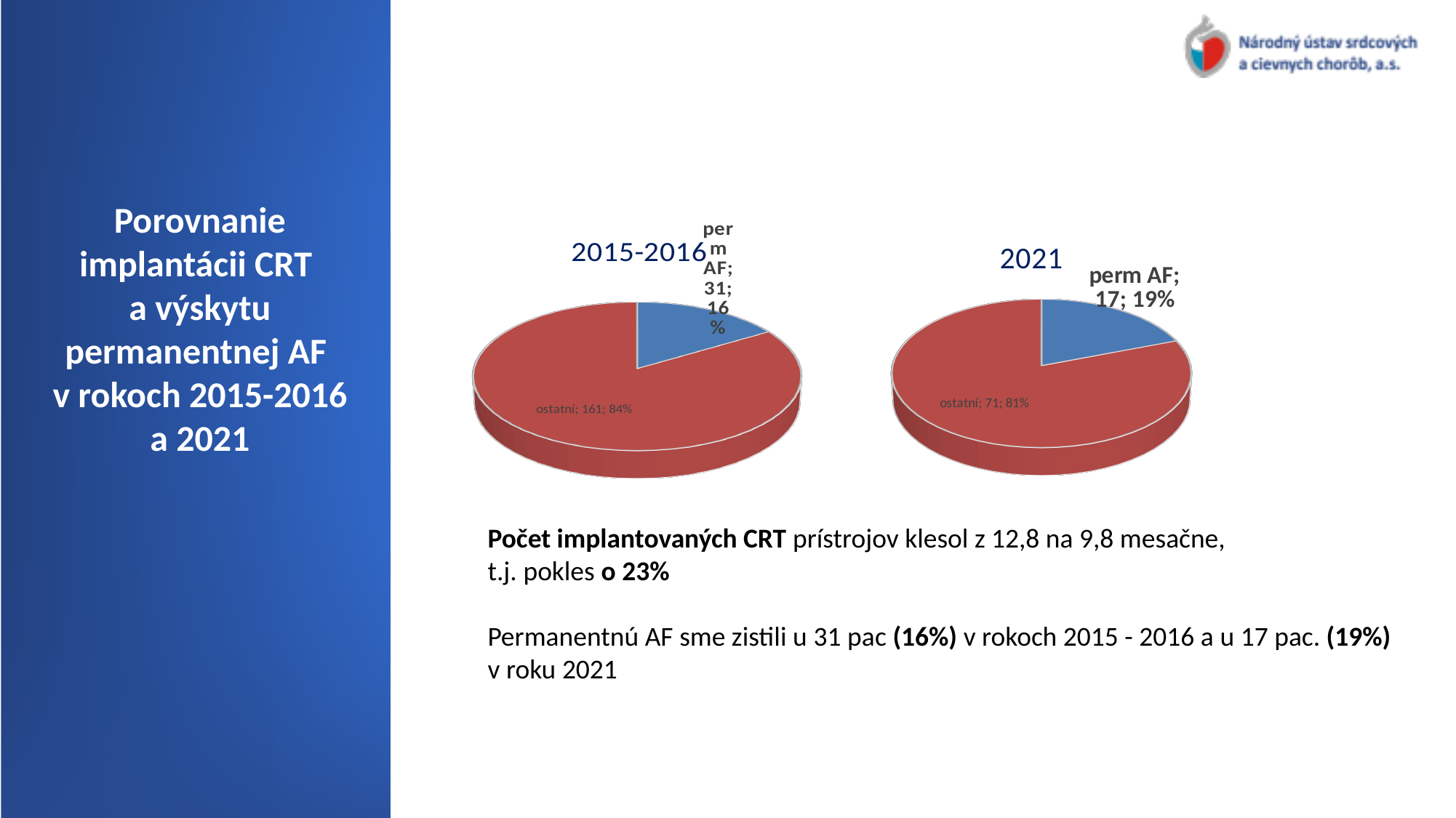
In the 2015-2016 chart, which slice is the smallest? perm AF Which is larger: the perm AF value in the 2015-2016 chart or the perm AF value in the 2021 chart? 2015-2016 In the 2021 chart, which slice is the largest? ostatní In the 2021 chart, what is the value for perm AF? 17 What type of chart is used for the 2015-2016 data? pie chart In the 2021 chart, what share of the pie does ostatní represent? 81% In the 2015-2016 chart, what share of the pie does perm AF represent? 16% In the 2021 chart, what is the value for ostatní? 71 In the 2015-2016 chart, what is the difference between the ostatní value and the perm AF value? 130 In the 2015-2016 chart, what is the value for perm AF? 31 How many slices does the 2021 pie chart have? 2 In the 2015-2016 chart, what is the value for ostatní? 161